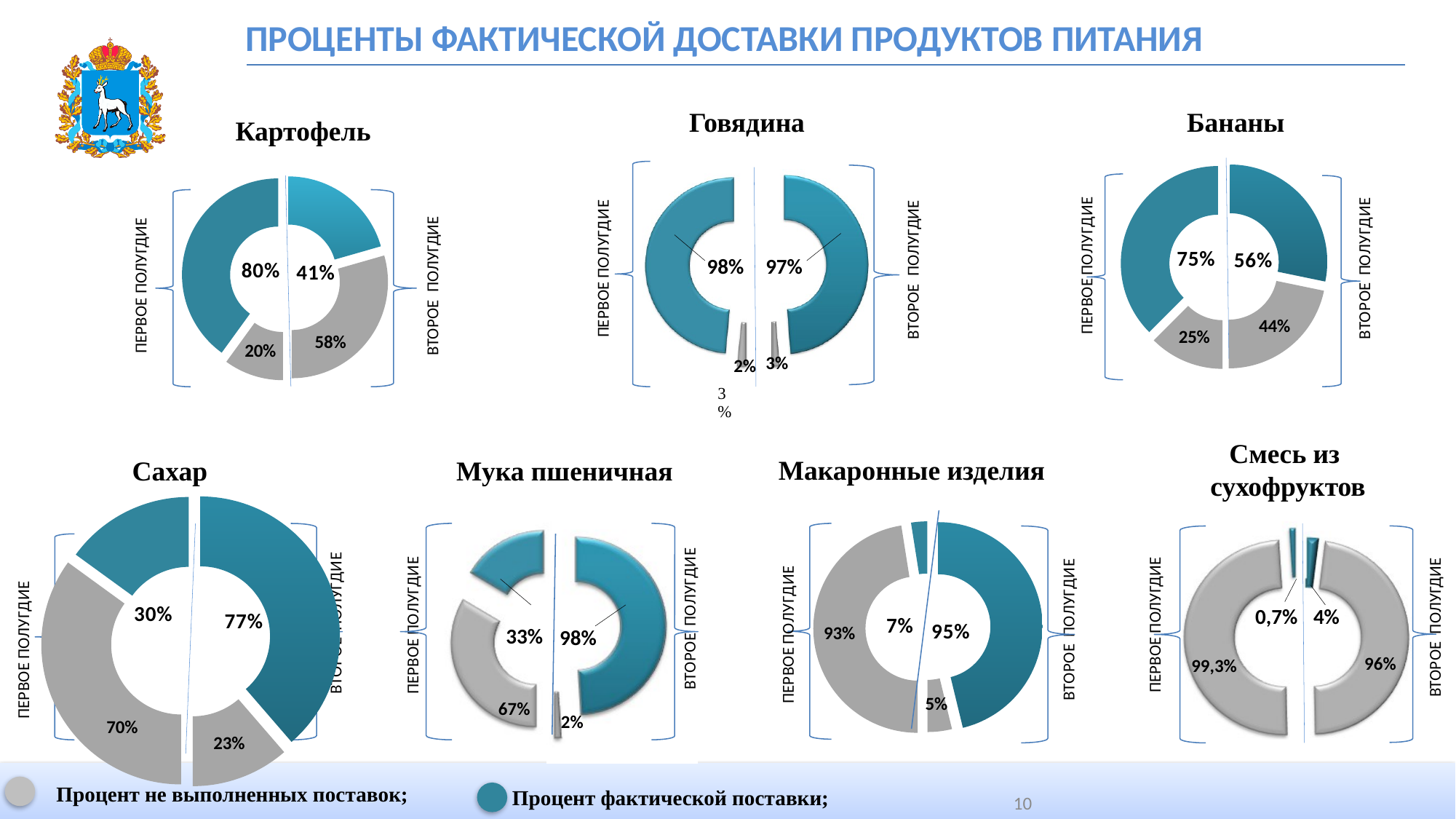
According to the legend, what does the grey colour represent? Процент не выполненных поставок In the Сахар chart, what is the difference between the actual delivery percentage in the second half-year and in the first half-year? 47% In the Говядина chart, what is the percentage of actual delivery in the second half-year? 97% In the Бананы chart, what is the percentage of unfulfilled deliveries in the first half-year? 25% In the Мука пшеничная chart, which half-year has the higher actual delivery percentage? Второе полугодие In the Картофель chart, what is the percentage of unfulfilled deliveries in the second half-year (второе полугодие)? 58% In the Макаронные изделия chart, what is the percentage of actual delivery in the first half-year? 7% Across all charts on the slide, which product has the lowest actual delivery percentage in the first half-year? Смесь из сухофруктов Across all charts on the slide, which product has the highest actual delivery percentage in the first half-year? Говядина What kind of chart is used for each product on the slide? Pie (donut) chart In the Смесь из сухофруктов chart, what is the percentage of unfulfilled deliveries in the first half-year? 99,3% In the Картофель chart, what is the percentage of actual delivery in the first half-year (первое полугодие)? 80%